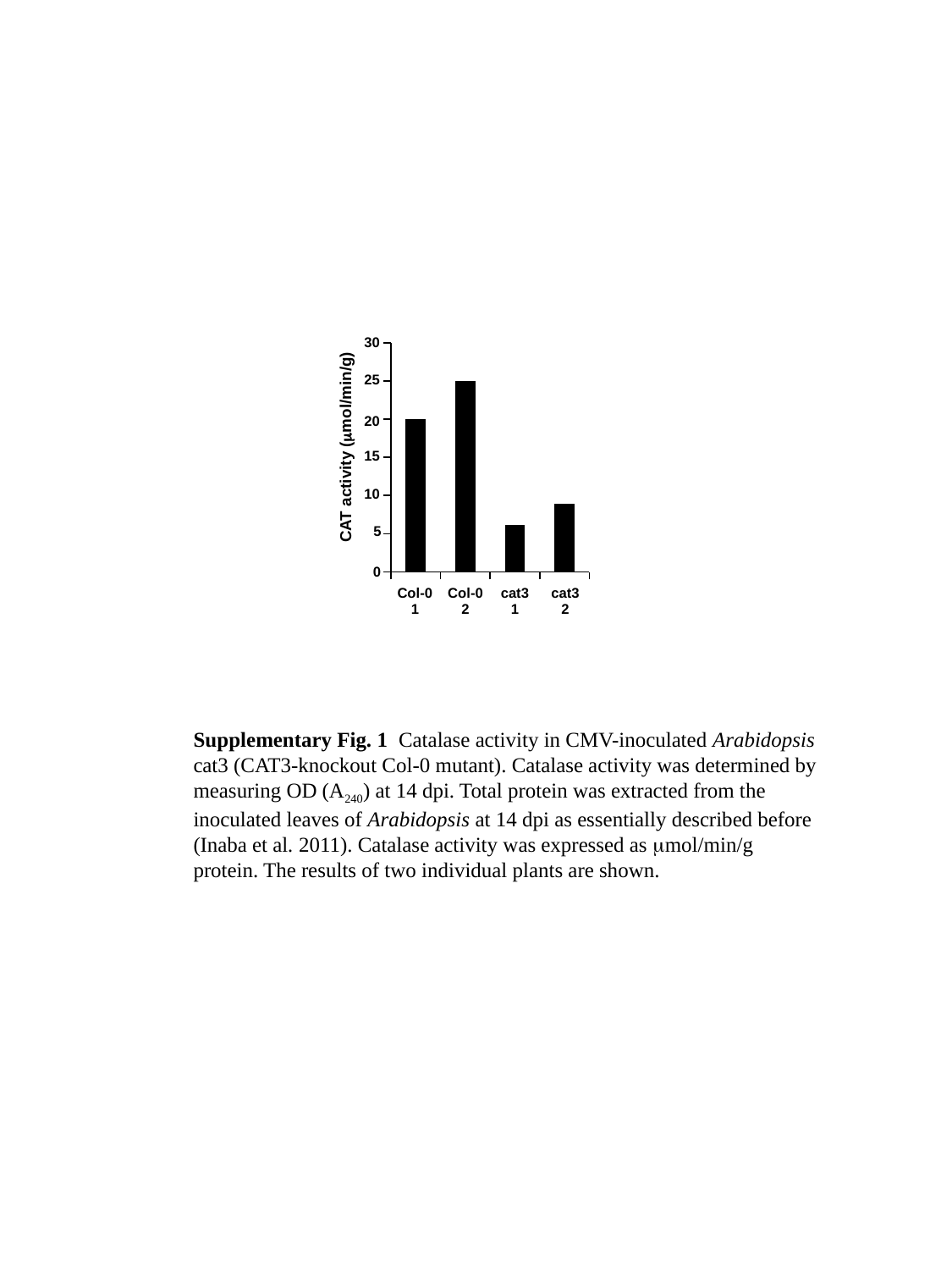
Is the value for cat3 1 greater or less than 10? less Which category has the lowest CAT activity? cat3 1 Which category has the highest CAT activity? Col-0 2 How many bars (categories) are plotted in the chart? 4 Which is larger, the value for Col-0 1 or the value for cat3 2? Col-0 1 What is the difference between the values for Col-0 2 and Col-0 1? 5 Is the value for cat3 2 greater or less than 5? greater What is the CAT activity value for Col-0 2? 25 What is the label of the y axis? CAT activity (μmol/min/g) What is the CAT activity value for Col-0 1? 20 What type of chart is shown on the slide? bar chart Is the value for cat3 2 greater or less than 10? less